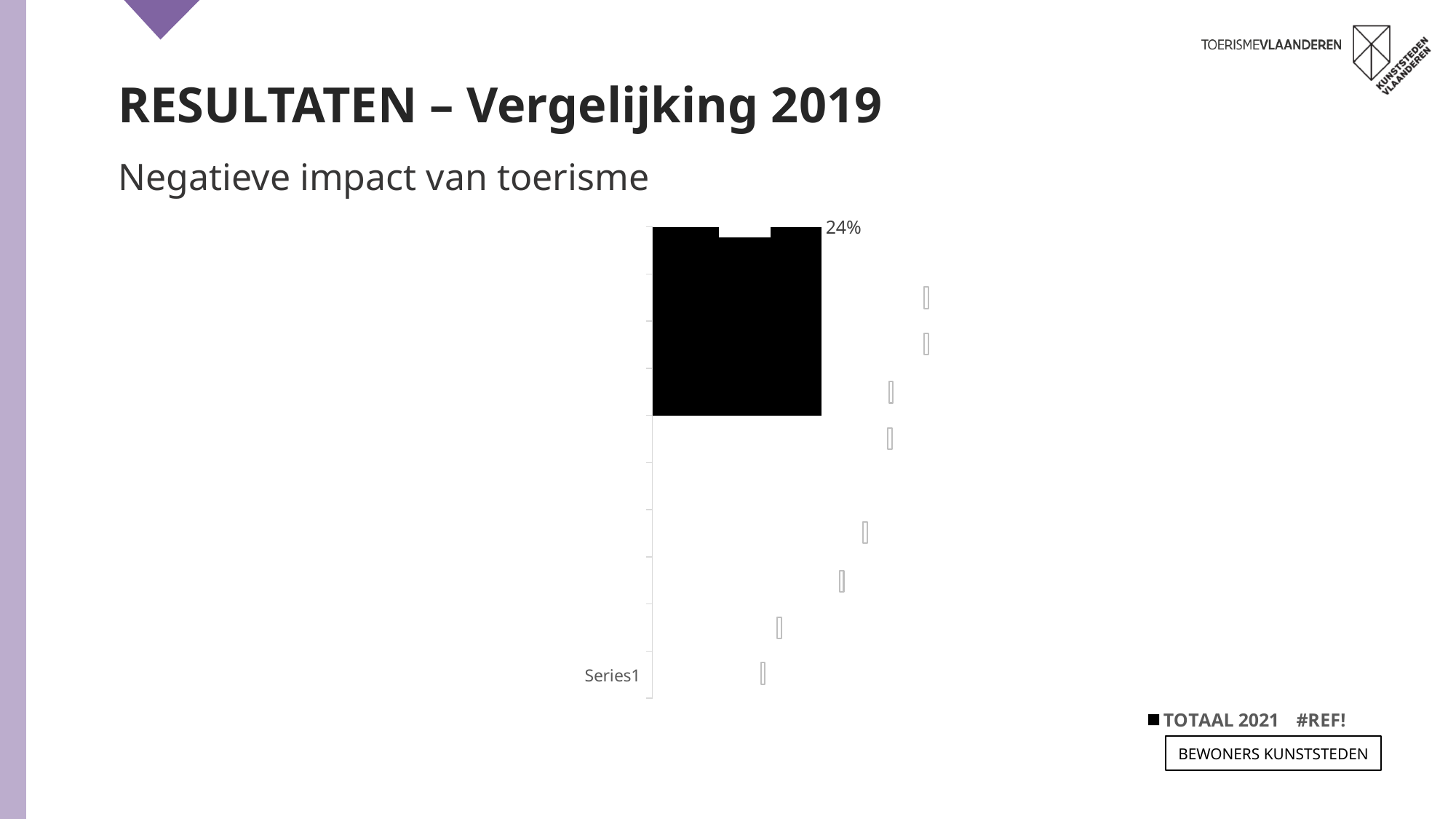
What is the first entry in the chart legend? TOTAAL 2021 What colour is the TOTAAL 2021 series in the chart? black What category label is shown on the vertical axis of the chart? Series1 What kind of chart is shown on the slide? bar chart How many series does the chart legend list? 2 What value is printed as the data label on the black bar? 24%